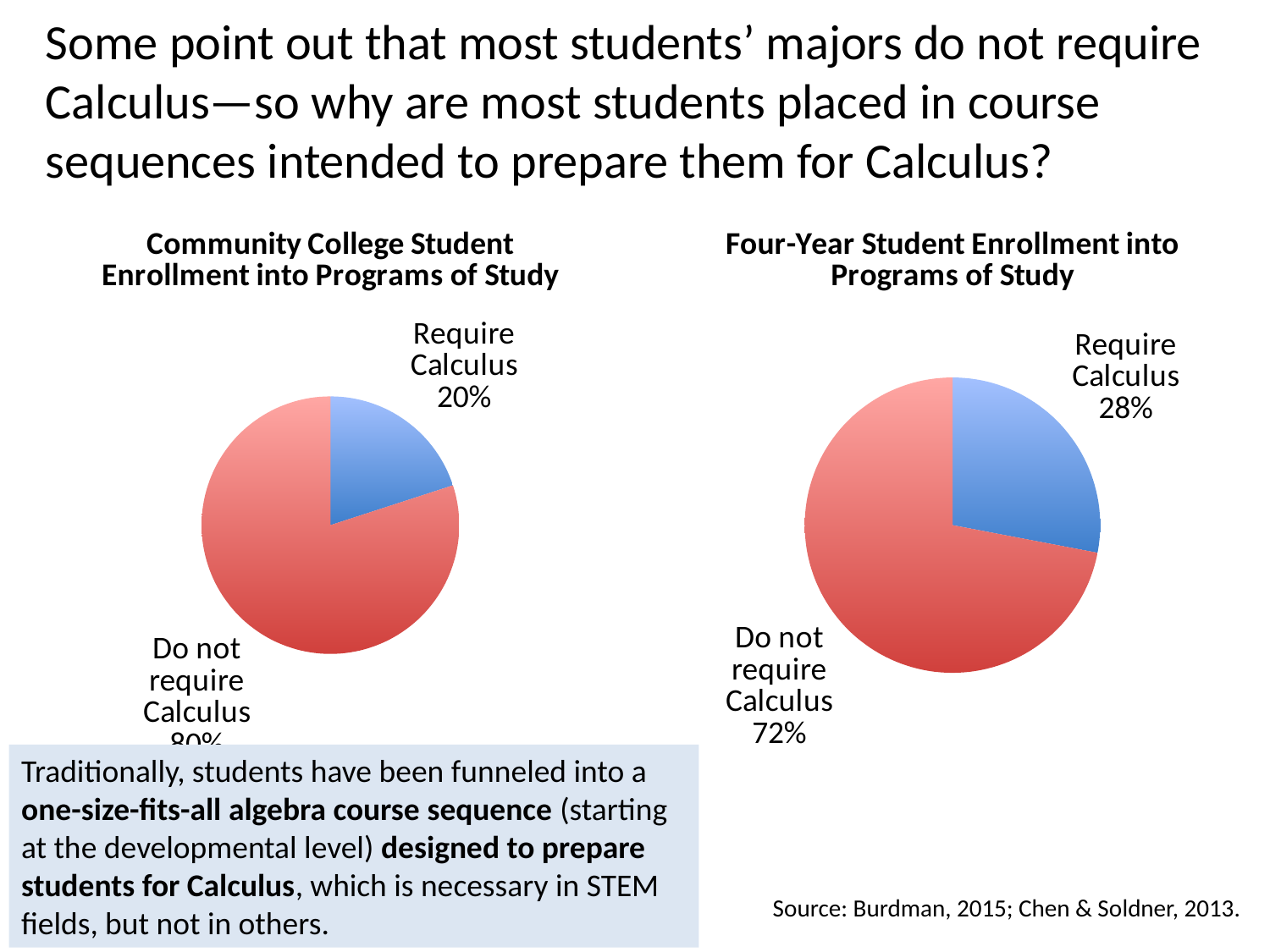
How many percentage points higher is the Require Calculus share in the Four-Year chart than in the Community College chart? 8 percentage points How many slices does the Four-Year Student Enrollment into Programs of Study pie chart have? 2 In the Four-Year Student Enrollment into Programs of Study chart, what percentage of students are in programs that do not require Calculus? 72% In the Community College Student Enrollment into Programs of Study chart, which slice is the smallest? Require Calculus Which chart shows a larger share of students in programs that require Calculus, the Community College chart or the Four-Year chart? Four-Year What kind of chart is the Community College Student Enrollment into Programs of Study chart? Pie chart In the Four-Year Student Enrollment into Programs of Study chart, what is the difference between the Do not require Calculus share and the Require Calculus share? 44 percentage points In the Four-Year Student Enrollment into Programs of Study chart, what percentage of students are in programs that require Calculus? 28% In the Community College Student Enrollment into Programs of Study chart, what percentage of students are in programs that require Calculus? 20% In the Community College Student Enrollment into Programs of Study chart, what share of the pie is taken by students in programs that do not require Calculus? 80% In the Four-Year Student Enrollment into Programs of Study chart, which slice is the largest? Do not require Calculus In the Four-Year Student Enrollment into Programs of Study chart, what colour is the Require Calculus slice? Blue